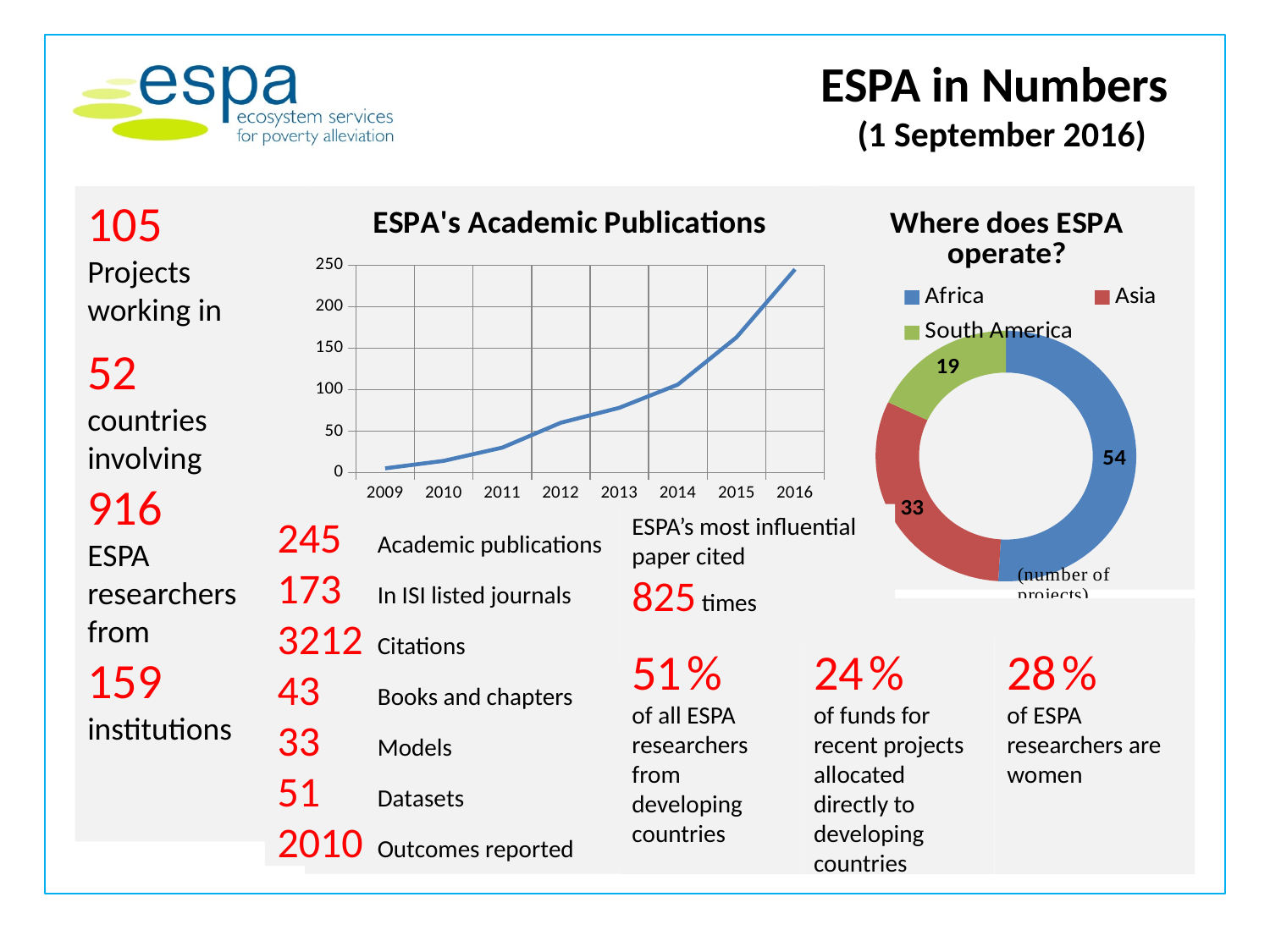
In the 'Where does ESPA operate?' chart, how many more projects are in Africa than in Asia? 21 In the 'ESPA's Academic Publications' chart, do the values rise or fall from 2009 to 2016? Rise In the 'Where does ESPA operate?' chart, which region has the fewest projects? South America In the 'ESPA's Academic Publications' chart, is the value for 2016 greater or less than 200? greater In the 'Where does ESPA operate?' chart, which region has the most projects? Africa How many regions does the legend of the 'Where does ESPA operate?' chart list? 3 In the 'Where does ESPA operate?' chart, how many projects are in Africa? 54 What kind of chart is 'ESPA's Academic Publications'? Line chart In the 'Where does ESPA operate?' chart, how many projects are in South America? 19 In the 'Where does ESPA operate?' chart, what is the total number of projects across all three regions? 106 In the 'Where does ESPA operate?' chart, how many projects are in Asia? 33 How many years are shown on the x axis of the 'ESPA's Academic Publications' chart? 8